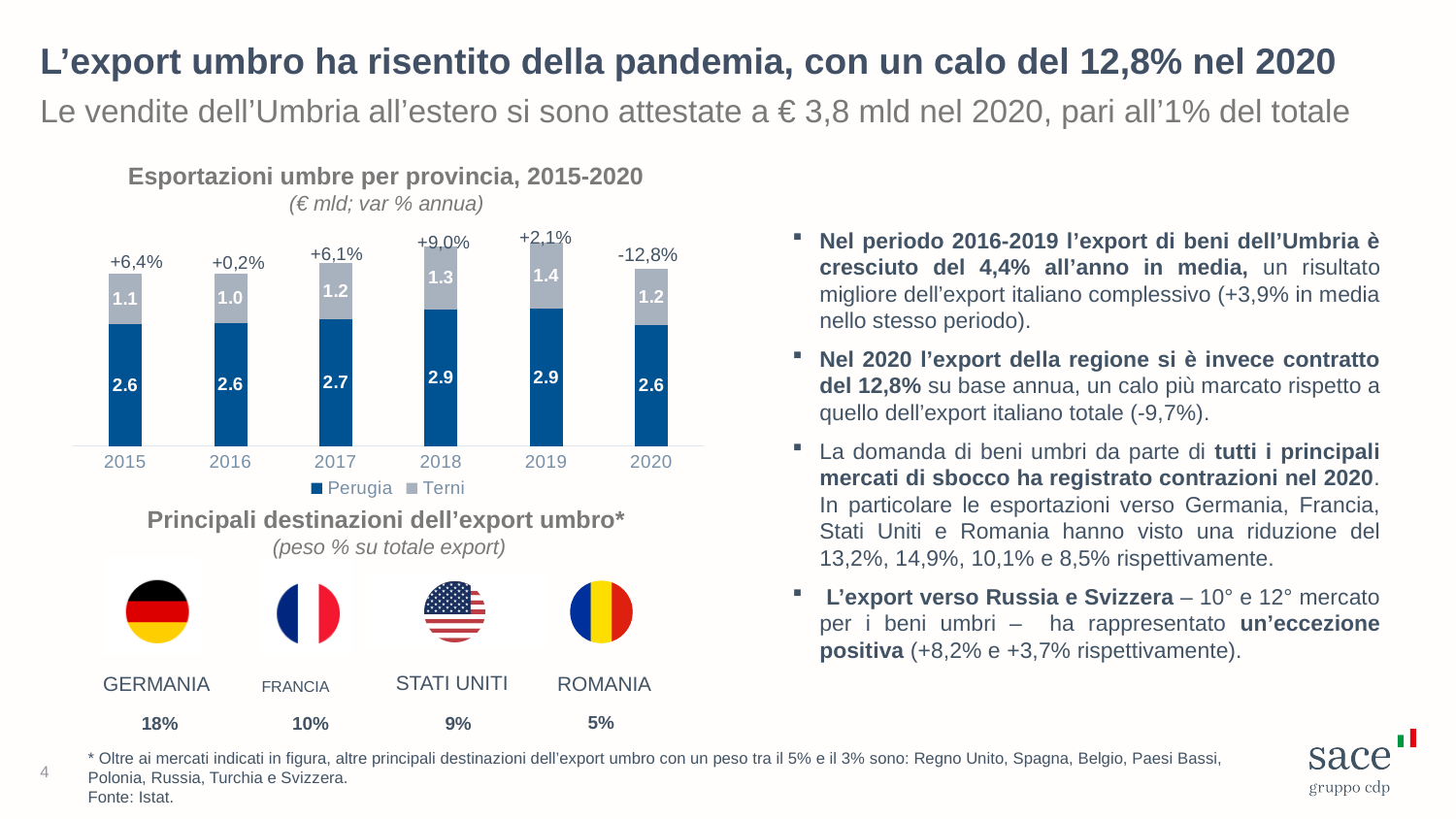
In the chart 'Esportazioni umbre per provincia, 2015-2020', is the Terni value larger in 2017 or in 2019? 2019 In the chart 'Esportazioni umbre per provincia, 2015-2020', what is the difference between the Perugia value in 2018 and the Perugia value in 2016? 0.3 In the chart 'Esportazioni umbre per provincia, 2015-2020', what is the total of the stacked bar for 2019? 4.3 In the chart 'Esportazioni umbre per provincia, 2015-2020', what annual percentage change is shown above the 2020 bar? -12,8% In the chart 'Esportazioni umbre per provincia, 2015-2020', which year has the highest value for Terni? 2019 How many series does the legend of the chart 'Esportazioni umbre per provincia, 2015-2020' list? 2 In the chart 'Esportazioni umbre per provincia, 2015-2020', what is the value for Terni in 2019? 1.4 In the chart 'Esportazioni umbre per provincia, 2015-2020', what is the value for Perugia in 2018? 2.9 What kind of chart is 'Esportazioni umbre per provincia, 2015-2020'? Stacked bar chart How many years are shown on the x axis of the chart 'Esportazioni umbre per provincia, 2015-2020'? 6 In the chart 'Esportazioni umbre per provincia, 2015-2020', which year has the lowest value for Terni? 2016 In the 'Principali destinazioni dell'export umbro' graphic, what share of total export goes to Germania? 18%